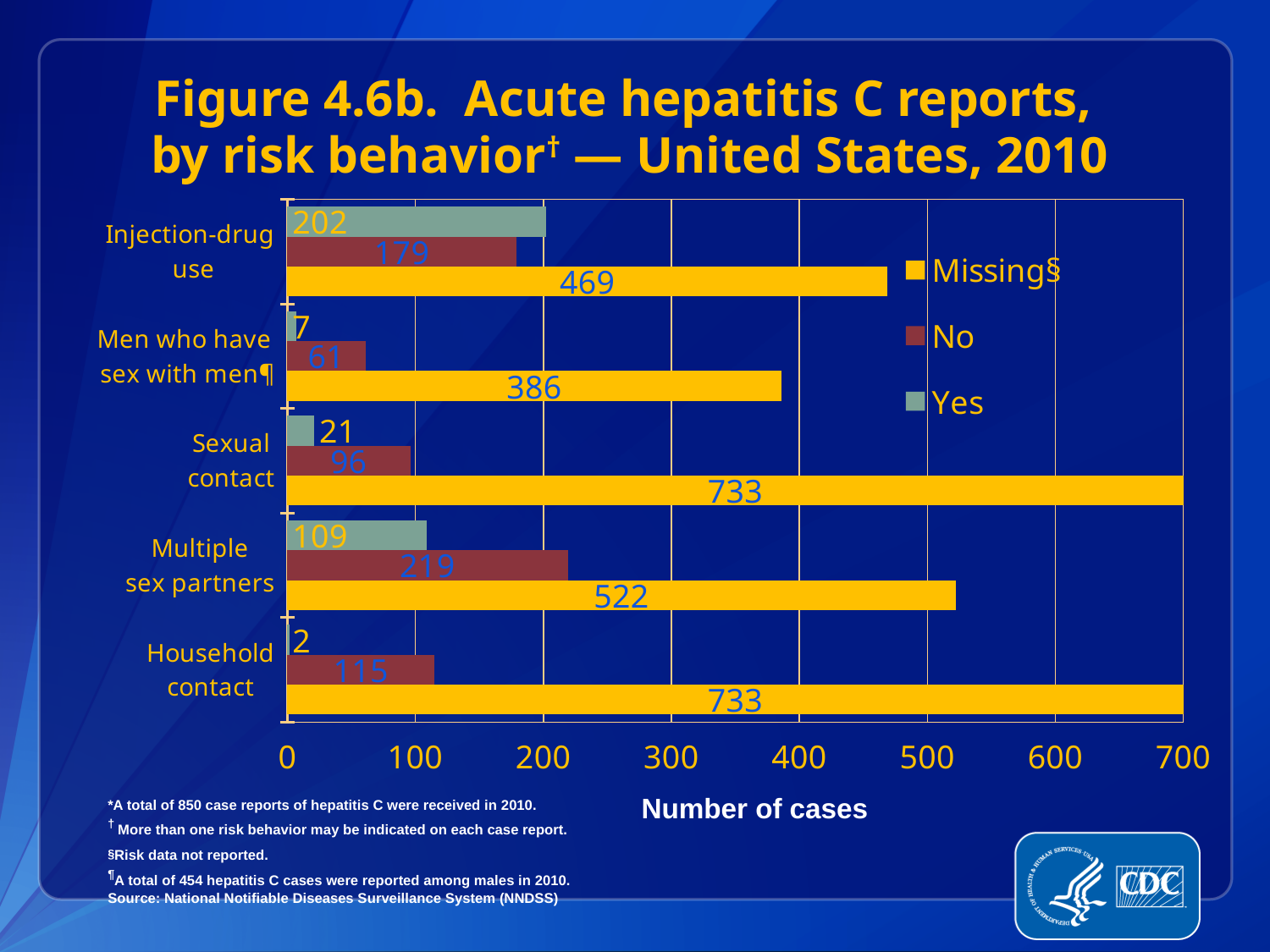
What is the number of cases in the Yes series for Injection-drug use? 202 Which risk behavior has the highest value in the Yes series? Injection-drug use How many risk behavior categories are shown on the chart? 5 What is the label of the x axis? Number of cases Which risk behavior has the lowest value in the Yes series? Household contact How many series does the legend list? 3 What is the number of cases in the No series for Household contact? 115 What is the number of cases in the Missing series for Multiple sex partners? 522 Which is larger: the Missing value for Injection-drug use or the Missing value for Men who have sex with men? Injection-drug use What is the difference between the No values for Multiple sex partners and Injection-drug use? 40 Is the Missing value for Sexual contact greater or less than 700? greater What kind of chart is shown on the slide? Bar chart